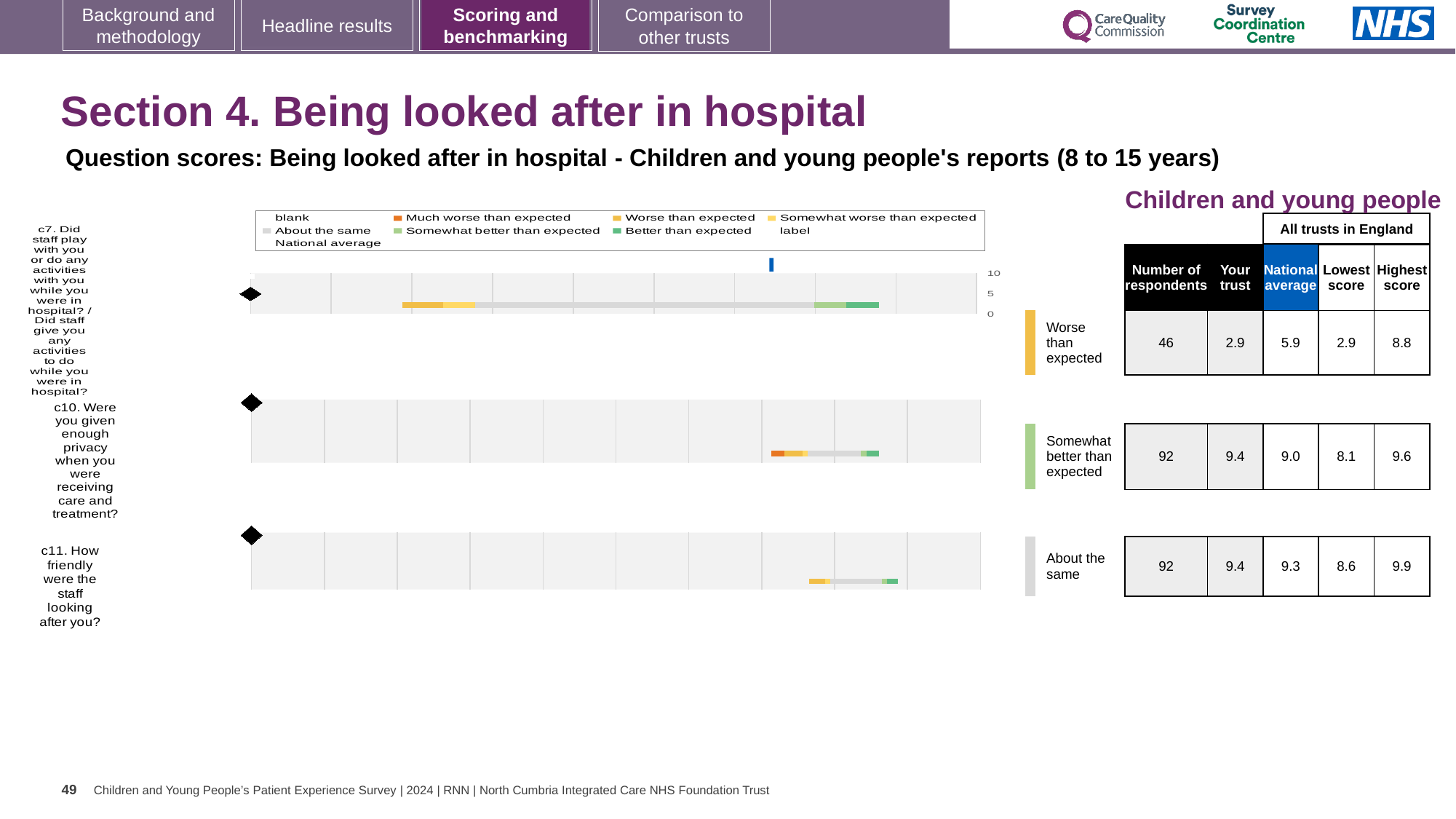
What is the difference between the highest score and the lowest score for c10? 1.5 What is the 'Your trust' score for c7 (Did staff play with you or do any activities with you while you were in hospital?)? 2.9 What benchmark category is the trust's c11 score placed in? About the same What is the national average score for c10 (Were you given enough privacy when you were receiving care and treatment?)? 9.0 For c7, which is larger: the trust score or the national average? national average How many respondents answered c11 (How friendly were the staff looking after you?)? 92 What benchmark category is the trust's c7 score placed in? Worse than expected What is the difference between the national average and the trust score for c7? 3.0 How many questions are plotted on the slide? 3 Which question has the lowest 'Your trust' score? c7 Is the trust score for c7 greater or less than 5? less What kind of chart is used to show the question scores for c7, c10 and c11? bar chart